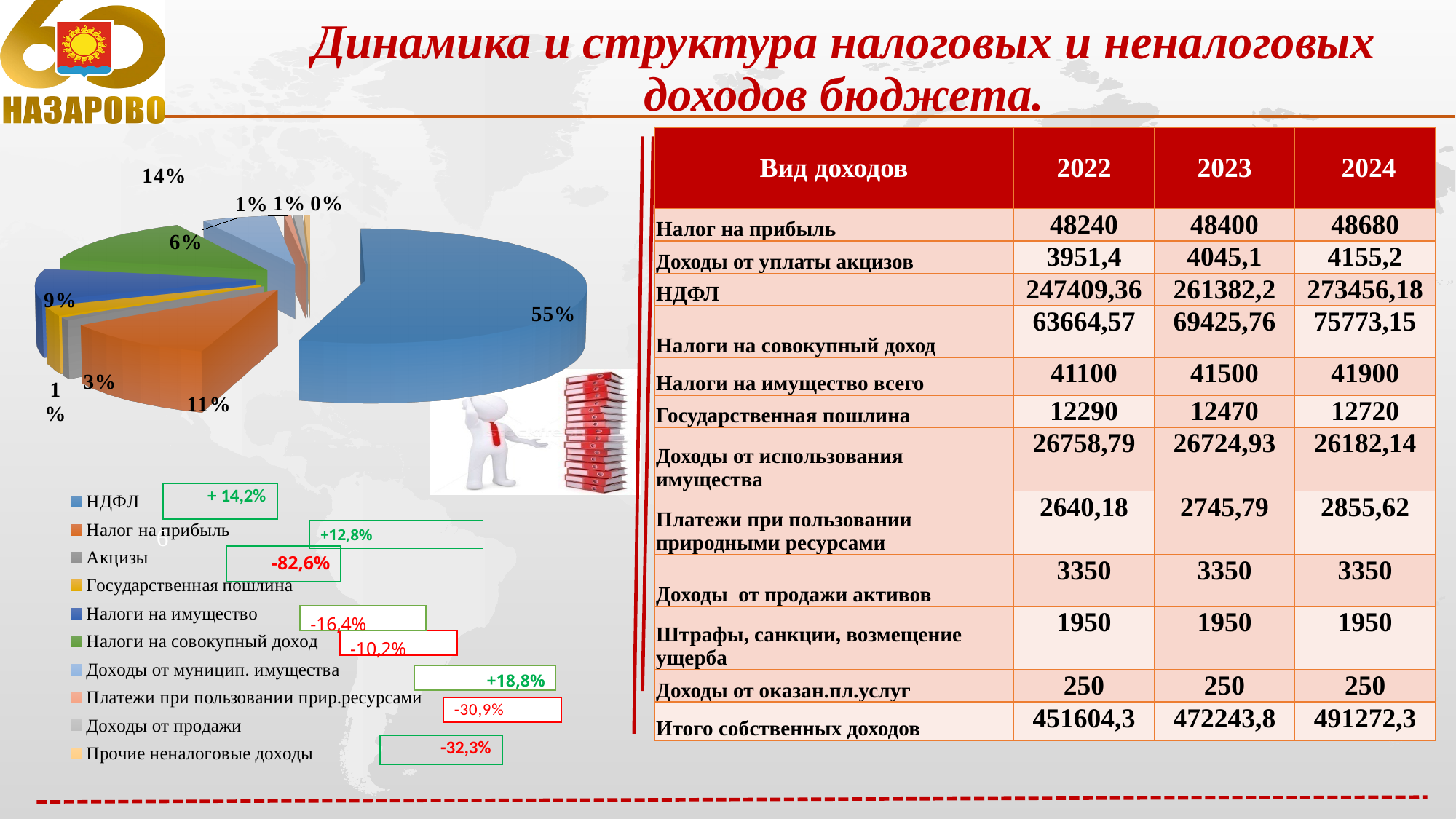
In the pie chart, what share does Налог на прибыль have? 11% In the pie chart, what share does НДФЛ have? 55% What kind of chart is shown on the left of the slide? pie chart How many categories does the pie chart legend list? 10 In the pie chart, what share does Акцизы have? 1% In the pie chart, which is larger: НДФЛ or Налог на прибыль? НДФЛ What colour is the НДФЛ slice in the pie chart? blue Which category has the largest slice in the pie chart? НДФЛ In the pie chart, what is the difference in percentage points between НДФЛ and Налог на прибыль? 44